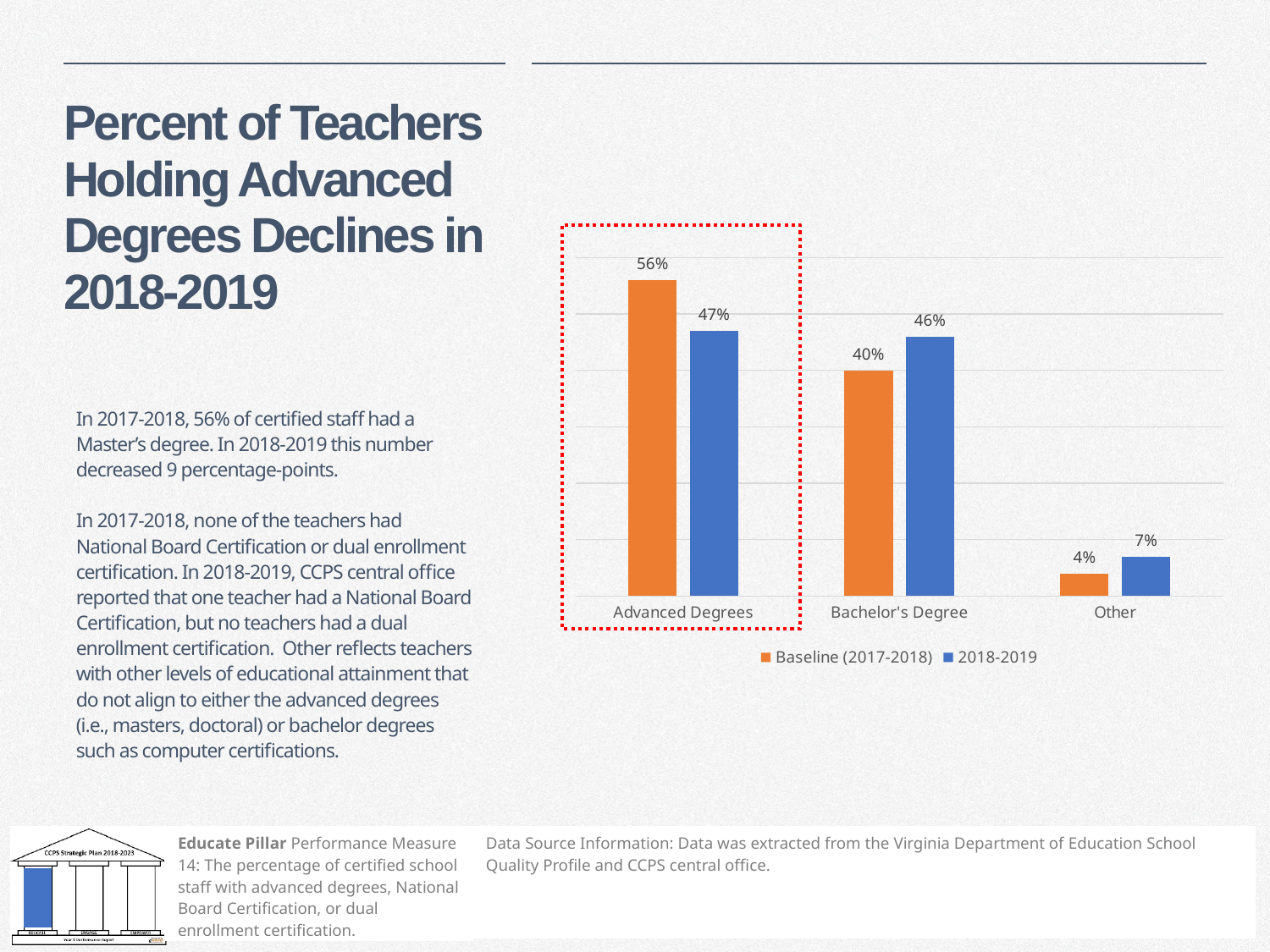
Which category is highlighted with a red dotted box? Advanced Degrees What is the Baseline (2017-2018) value for Advanced Degrees? 56% What is the difference between the 2018-2019 and Baseline (2017-2018) values for Bachelor's Degree? 6% How many categories are shown on the x axis? 3 What is the 2018-2019 value for Other? 7% How many series does the legend list? 2 What is the 2018-2019 value for Bachelor's Degree? 46% Which category has the highest Baseline (2017-2018) value? Advanced Degrees Which is larger for Bachelor's Degree: the Baseline (2017-2018) value or the 2018-2019 value? 2018-2019 Which category has the lowest 2018-2019 value? Other What is the difference between the Baseline (2017-2018) and 2018-2019 values for Advanced Degrees? 9% What kind of chart is shown on the slide? Bar chart